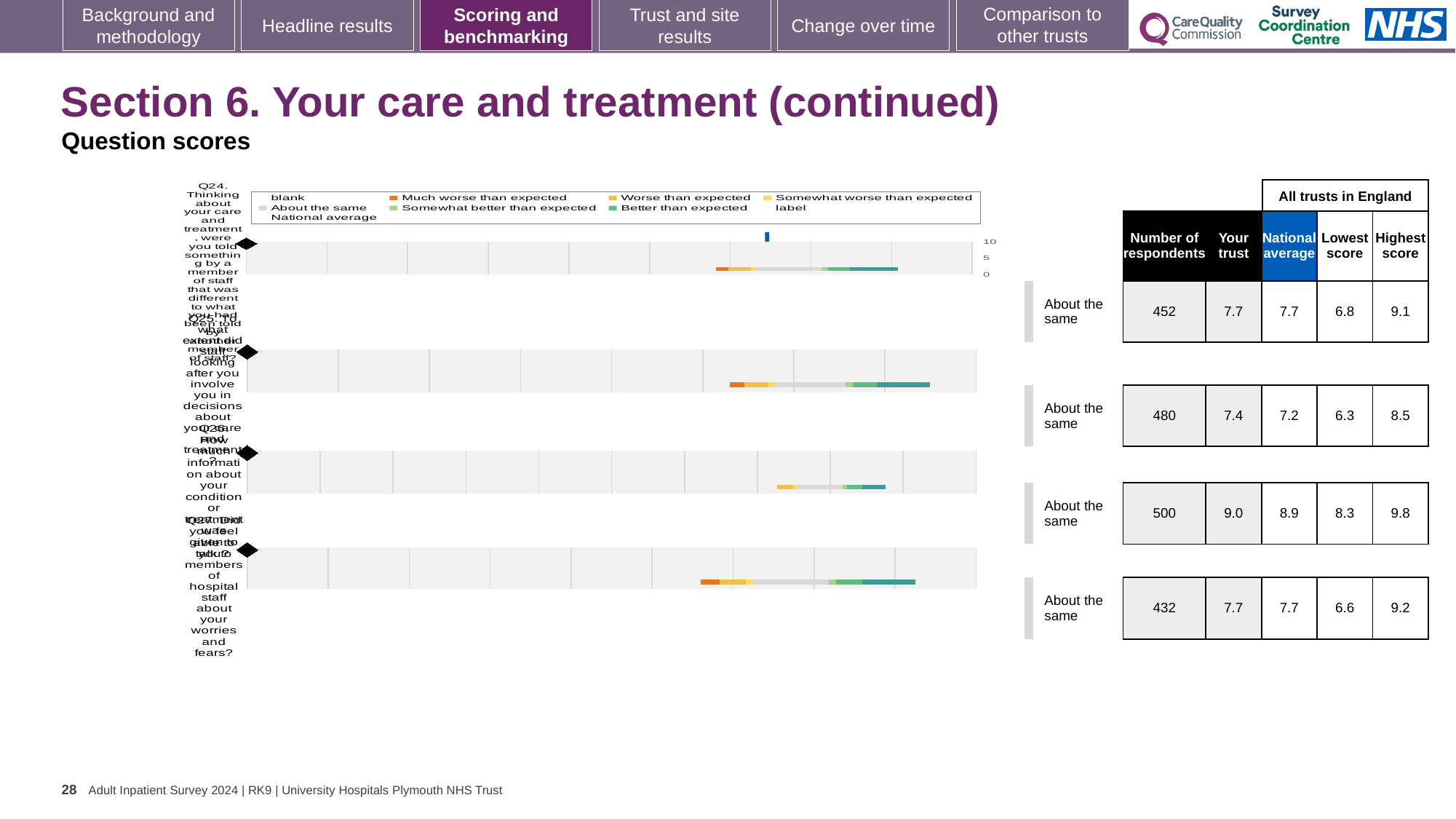
In the table beside the chart, what is the national average for the third row (Q26)? 8.9 Which row has the lowest number of respondents in the table beside the chart? Q27 What is the heading above the 'National average', 'Lowest score' and 'Highest score' columns in the table? All trusts in England Which row has the highest 'Your trust' score in the table beside the chart? Q26 In the table beside the chart, what is the highest score for the fourth row (Q27)? 9.2 What is the difference between the highest score and the lowest score for the first row (Q24) in the table? 2.3 How many question rows (bars) are plotted in the chart? 4 In the table beside the chart, what is the 'Your trust' score for the second row (Q25)? 7.4 What kind of chart is shown on the slide? bar chart In the table beside the chart, what is the number of respondents for the first row (Q24)? 452 For the second row (Q25), which is larger: the 'Your trust' score or the national average? Your trust What benchmark category label is shown next to each of the four bars? About the same